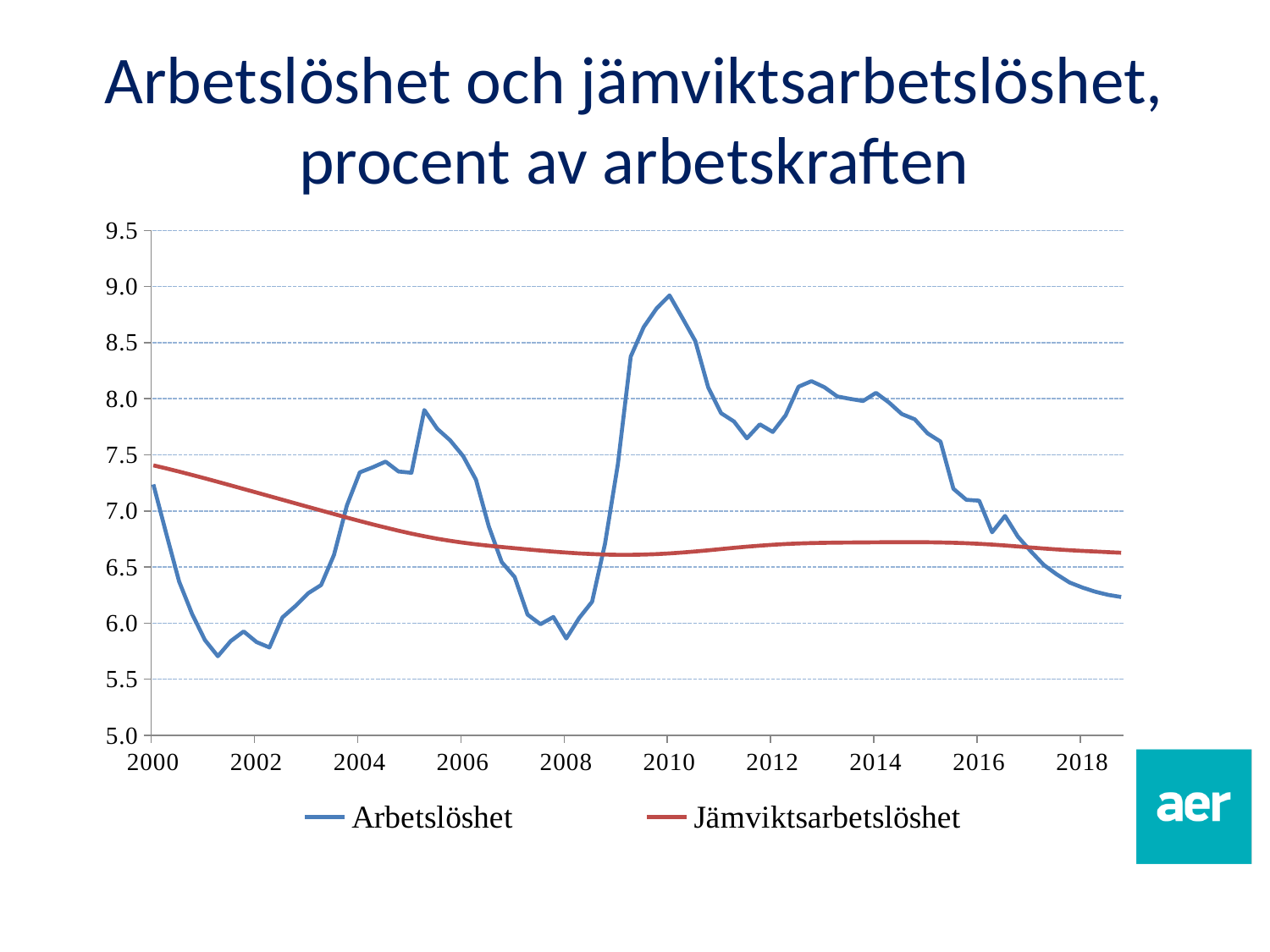
In 2010, which series has the higher value, Arbetslöshet or Jämviktsarbetslöshet? Arbetslöshet In 2002, which series has the higher value, Arbetslöshet or Jämviktsarbetslöshet? Jämviktsarbetslöshet Does the Jämviktsarbetslöshet line rise or fall between 2000 and 2008? Fall Is the value for Arbetslöshet in 2010 greater or less than 8.5? greater Around which year does the Arbetslöshet line reach its highest point? 2010 What kind of chart is shown on the slide? Line chart How many series does the legend list? 2 Is the value for Jämviktsarbetslöshet in 2000 greater or less than 7.0? greater What are the two series named in the legend? Arbetslöshet and Jämviktsarbetslöshet Which colour is the Jämviktsarbetslöshet line? Red Is the value for Arbetslöshet in 2008 greater or less than 6.5? less